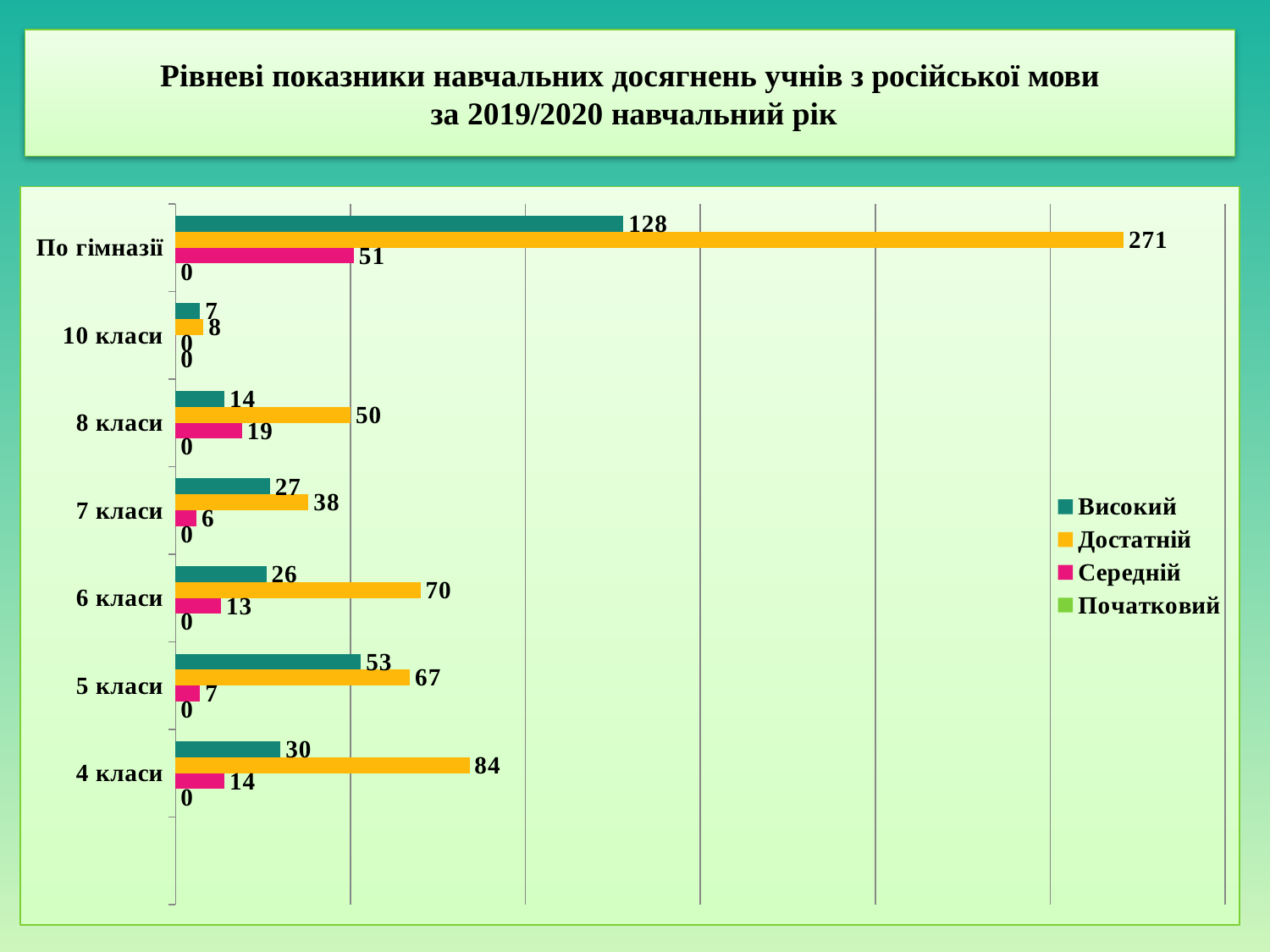
What kind of chart is shown on the slide? bar chart Among the class categories (excluding По гімназії), which has the highest Достатній value? 4 класи What is the value of Початковий for 6 класи? 0 What is the value of Високий for 5 класи? 53 What is the value of Середній for 8 класи? 19 What is the difference between the Достатній and Високий values for 6 класи? 44 How many series does the legend list? 4 Which series is shown in pink/magenta in the legend? Середній What is the value of Достатній for По гімназії? 271 Which is larger for 7 класи: Високий or Достатній? Достатній Which category has the lowest Високий value? 10 класи How many categories are shown on the vertical axis? 7